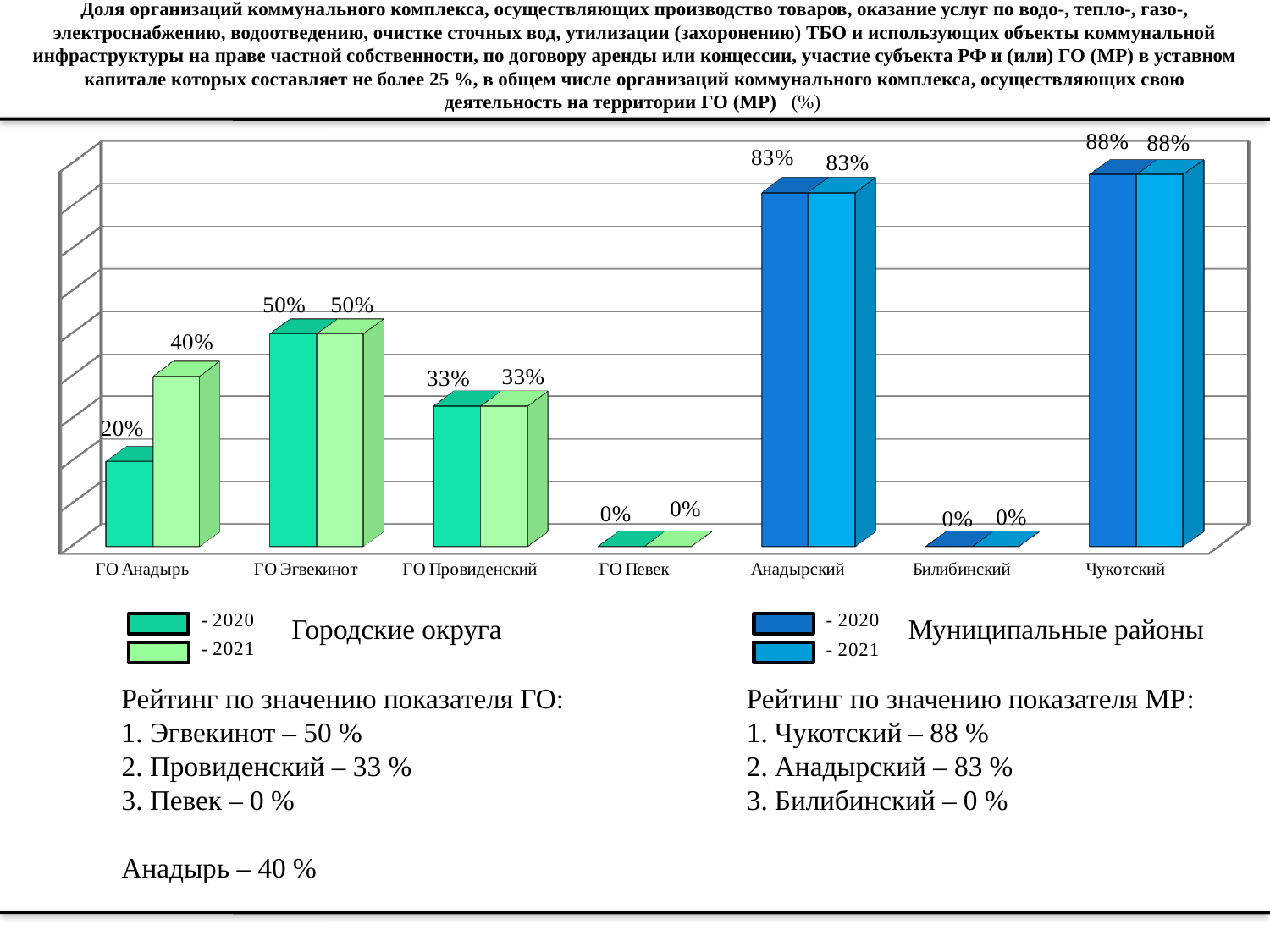
Which has the larger 2021 value, ГО Эгвекинот or ГО Провиденский? ГО Эгвекинот What is the value for Анадырский in 2020? 83% Which category has the highest value in 2021? Чукотский How many categories are shown on the x axis? 7 What is the value for ГО Анадырь in 2021? 40% By how much did the value for ГО Анадырь increase from 2020 to 2021? 20% Which two years does the legend list? 2020 and 2021 What kind of chart is shown on the slide? Bar chart How many categories have a value of 0% in both years? 2 What is the difference between the 2021 values for Чукотский and Анадырский? 5% What is the value for Чукотский in 2021? 88% What is the value for ГО Анадырь in 2020? 20%